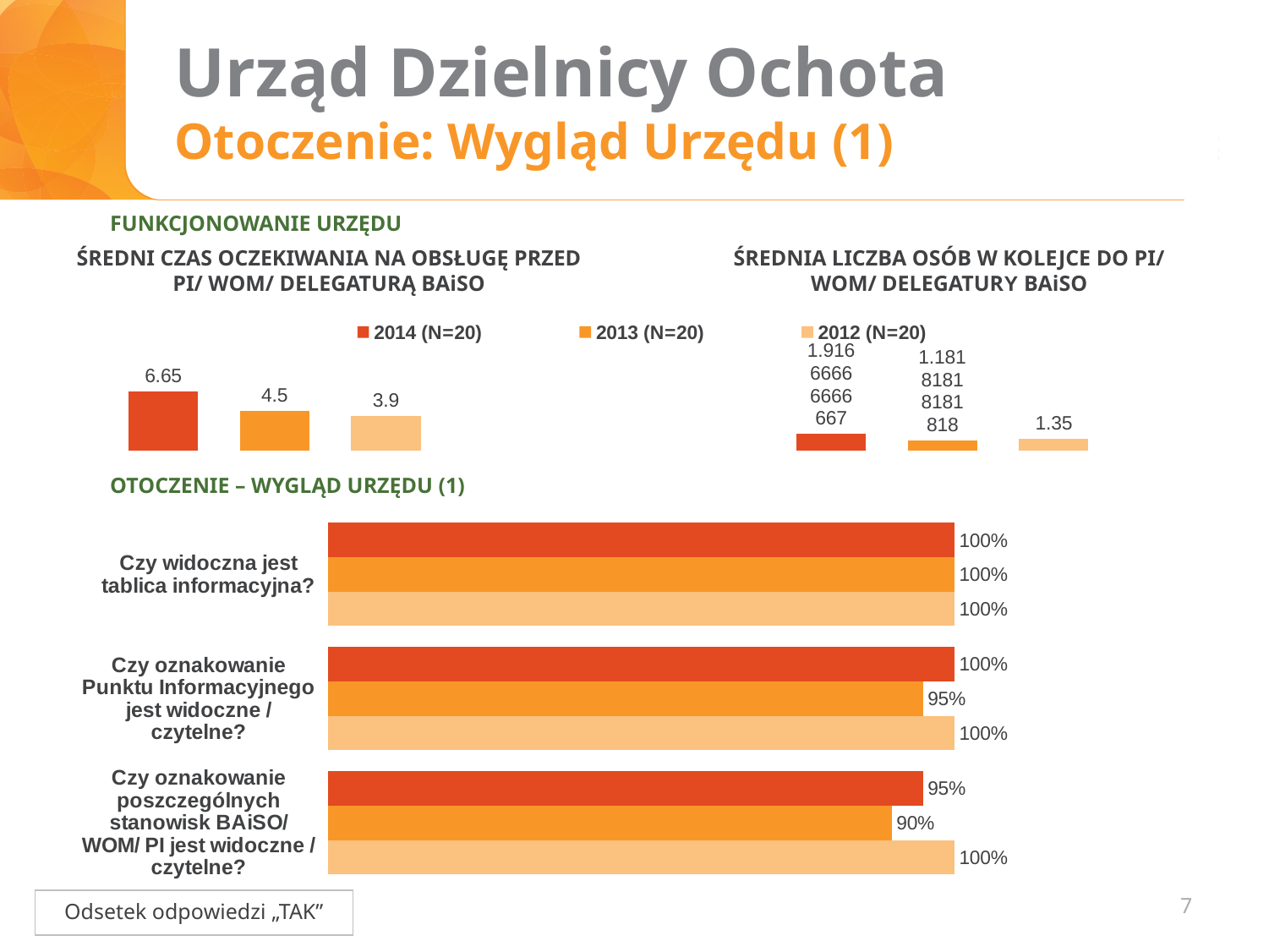
In the bottom chart 'OTOCZENIE – WYGLĄD URZĘDU (1)', what is the 2013 value for 'Czy oznakowanie Punktu Informacyjnego jest widoczne / czytelne?'? 95% In the chart 'ŚREDNIA LICZBA OSÓB W KOLEJCE DO PI/ WOM/ DELEGATURY BAiSO', which year has the highest value? 2014 (N=20) In the chart 'ŚREDNI CZAS OCZEKIWANIA NA OBSŁUGĘ PRZED PI/ WOM/ DELEGATURĄ BAiSO', what is the value for 2014 (N=20)? 6.65 In the chart 'ŚREDNIA LICZBA OSÓB W KOLEJCE DO PI/ WOM/ DELEGATURY BAiSO', what is the value for 2012 (N=20)? 1.35 In the chart 'ŚREDNI CZAS OCZEKIWANIA NA OBSŁUGĘ PRZED PI/ WOM/ DELEGATURĄ BAiSO', what is the difference between the 2014 and 2013 values? 2.15 In the bottom chart 'OTOCZENIE – WYGLĄD URZĘDU (1)', what is the 2013 value for 'Czy oznakowanie poszczególnych stanowisk BAiSO/ WOM/ PI jest widoczne / czytelne?'? 90% In the bottom chart 'OTOCZENIE – WYGLĄD URZĘDU (1)', how many question categories are shown? 3 How many series does the legend list? 3 What type of chart is the bottom chart 'OTOCZENIE – WYGLĄD URZĘDU (1)'? Bar chart In the chart 'ŚREDNI CZAS OCZEKIWANIA NA OBSŁUGĘ PRZED PI/ WOM/ DELEGATURĄ BAiSO', which year has the highest value? 2014 (N=20) In the chart 'ŚREDNI CZAS OCZEKIWANIA NA OBSŁUGĘ PRZED PI/ WOM/ DELEGATURĄ BAiSO', what is the value for 2012 (N=20)? 3.9 In the bottom chart 'OTOCZENIE – WYGLĄD URZĘDU (1)', what is the 2014 value for 'Czy oznakowanie poszczególnych stanowisk BAiSO/ WOM/ PI jest widoczne / czytelne?'? 95%